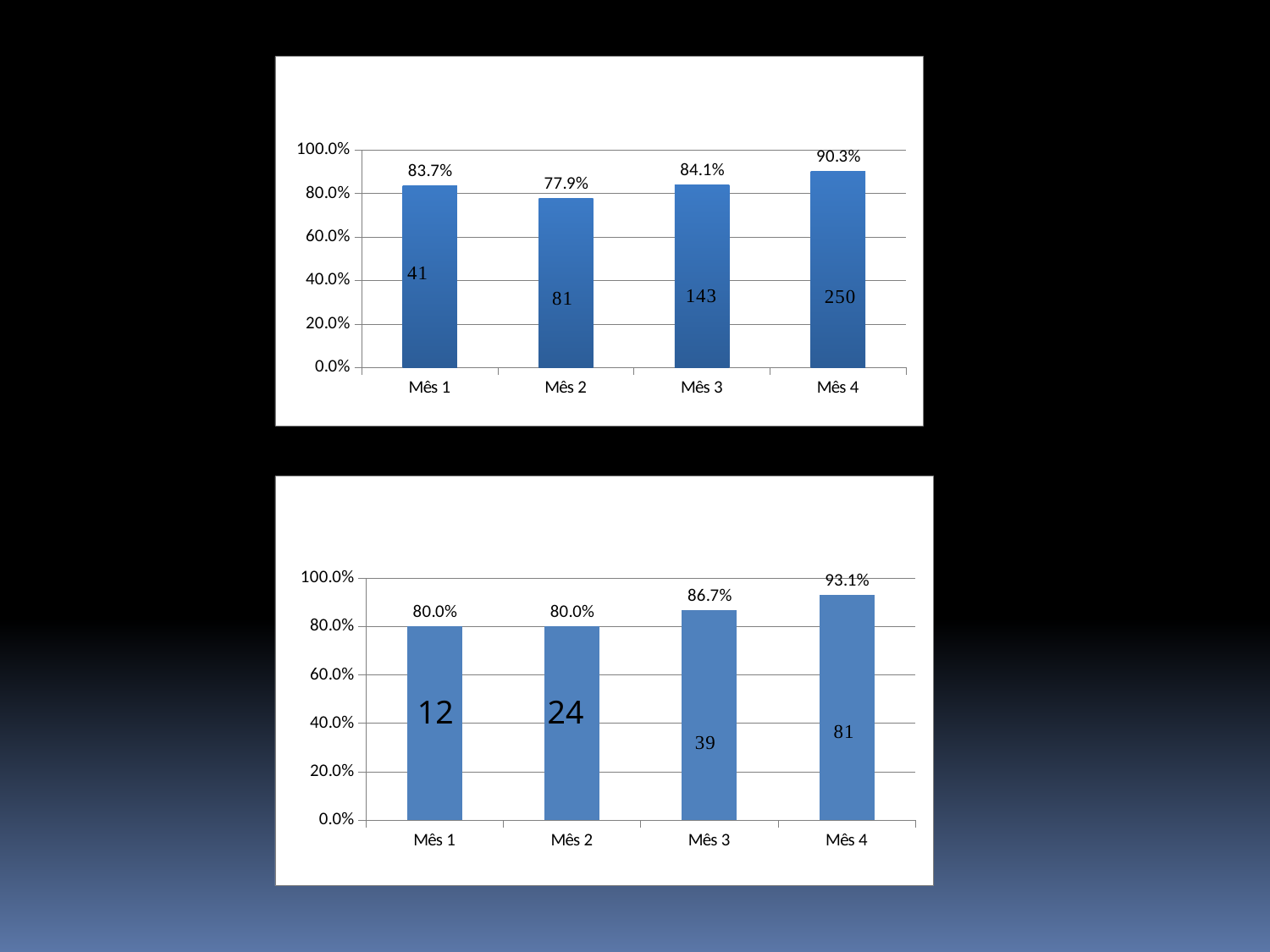
How many categories are shown on the x axis of the bottom chart? 4 In the top chart, which category has the lowest value? Mês 2 In the top chart, is the value for Mês 2 greater or less than 80.0%? less What kind of chart is the top chart? bar chart In the bottom chart, what is the value for Mês 3? 86.7% In the top chart, what is the value for Mês 4? 90.3% In the top chart, what is the difference between the values for Mês 4 and Mês 2? 12.4 percentage points In the bottom chart, which category has the highest value? Mês 4 In the bottom chart, what is the difference between the values for Mês 4 and Mês 1? 13.1 percentage points In the top chart, what is the value for Mês 2? 77.9% In the top chart, which category has the highest value? Mês 4 In the top chart, which is larger, the value for Mês 2 or the value for Mês 3? Mês 3